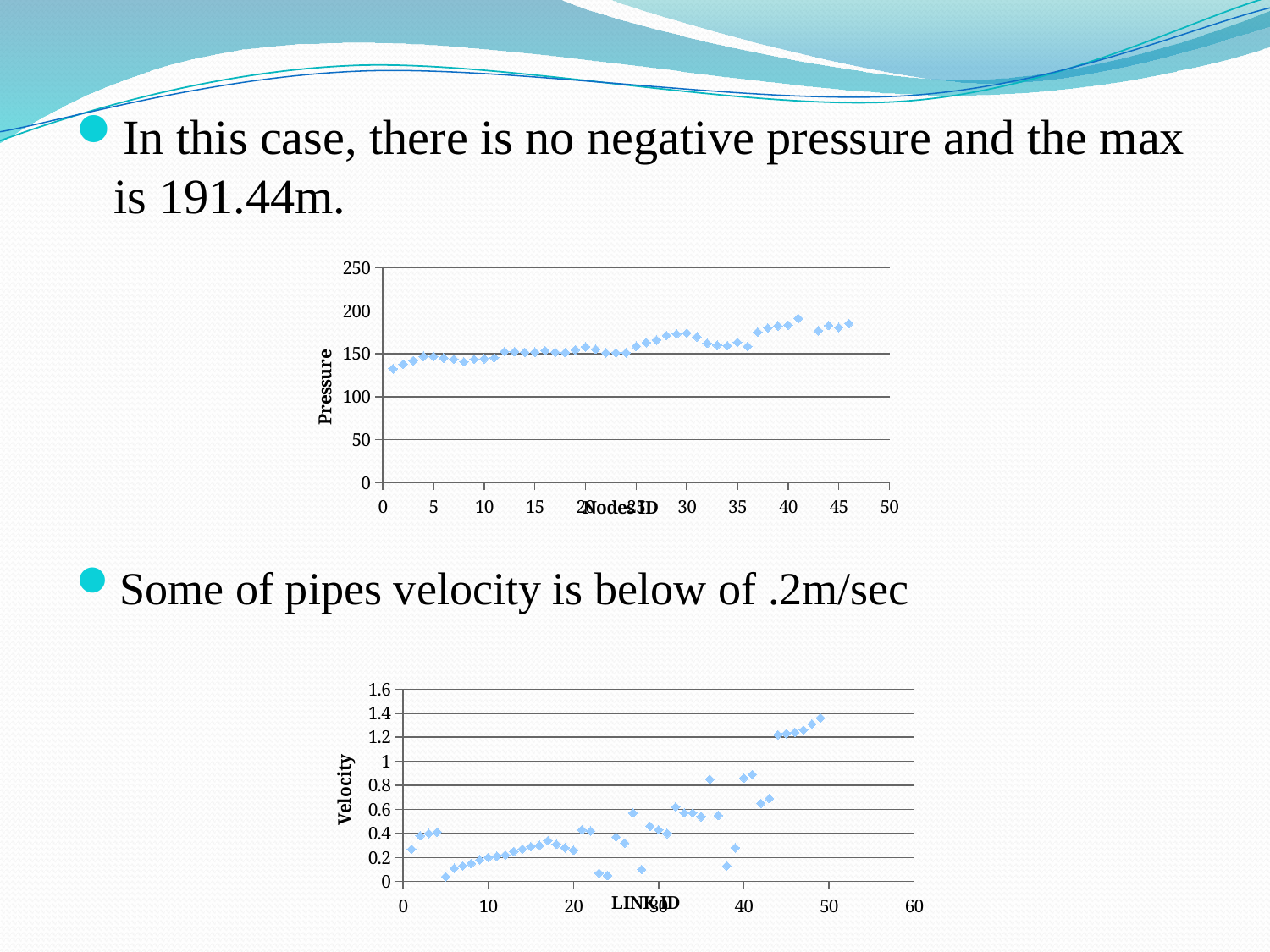
In the top chart, is the pressure value at node ID 30 greater or less than 200? less In the top chart, do the pressure values generally rise or fall as the node ID increases? rise In the bottom chart, is the velocity value at link ID 5 greater or less than 0.2? less In the bottom chart, is the velocity value at link ID 49 greater or less than 1.2? greater In the top chart, what is the label of the vertical axis? Pressure What kind of chart is the bottom chart (Velocity vs LINK ID)? scatter chart In the bottom chart, what is the label of the vertical axis? Velocity In the bottom chart, what is the highest value shown on the vertical axis? 1.6 What kind of chart is the top chart (Pressure vs Nodes ID)? scatter chart